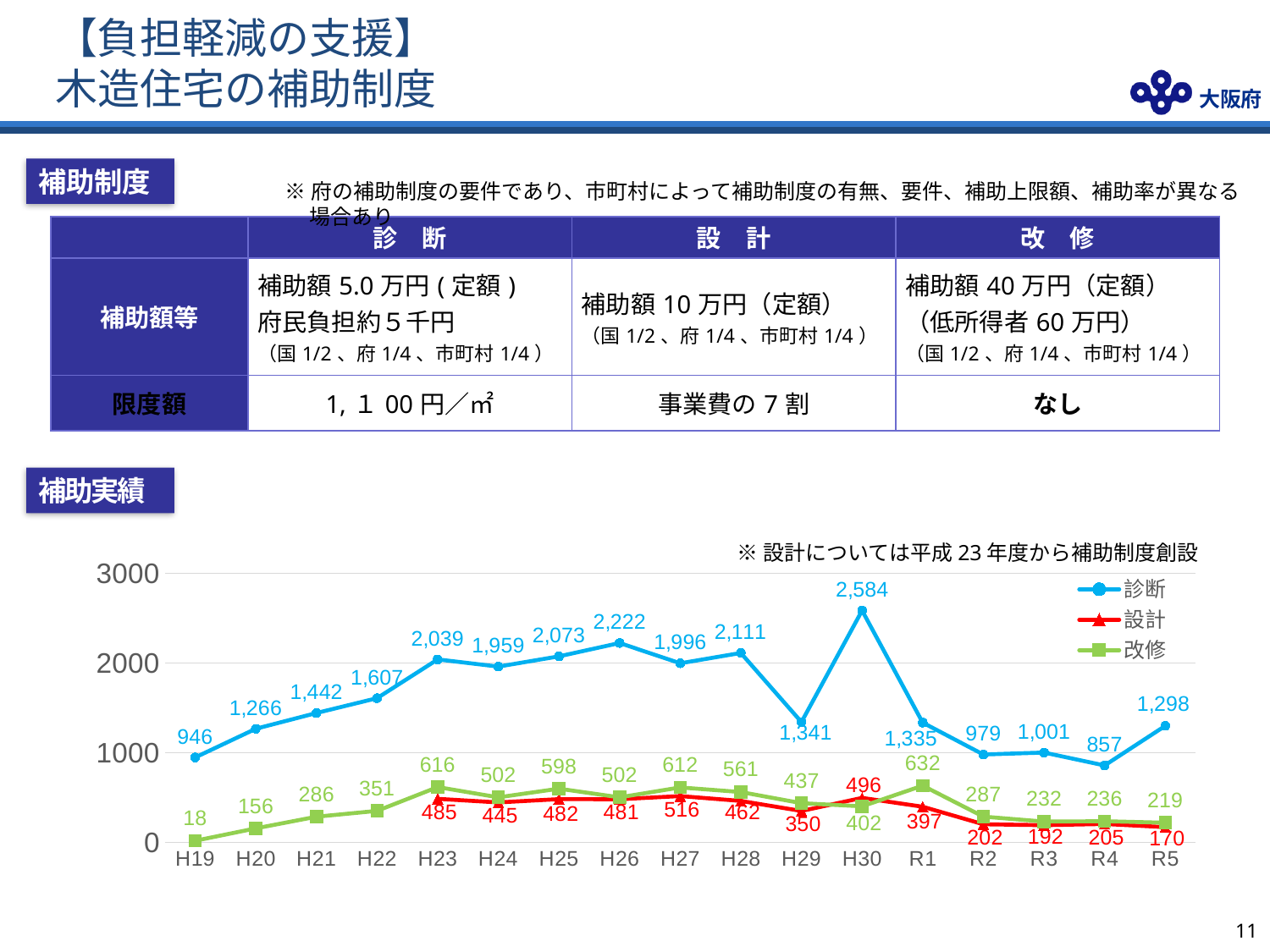
What is the value of 改修 in H19? 18 How many fiscal years are shown on the x axis of the 補助実績 chart? 17 Which series is drawn in red on the 補助実績 chart? 設計 What is the difference between 診断 in H30 and 診断 in R1? 1,249 What is the value of 設計 in R5? 170 How many series does the legend of the 補助実績 chart list? 3 In which year does 診断 reach its highest value? H30 In which year is 改修 at its lowest value? H19 Is the value of 診断 in R4 greater or less than 1000? less Which is larger in H23, 改修 or 設計? 改修 What is the value of 診断 in H30? 2,584 What type of chart is shown under 補助実績? line chart